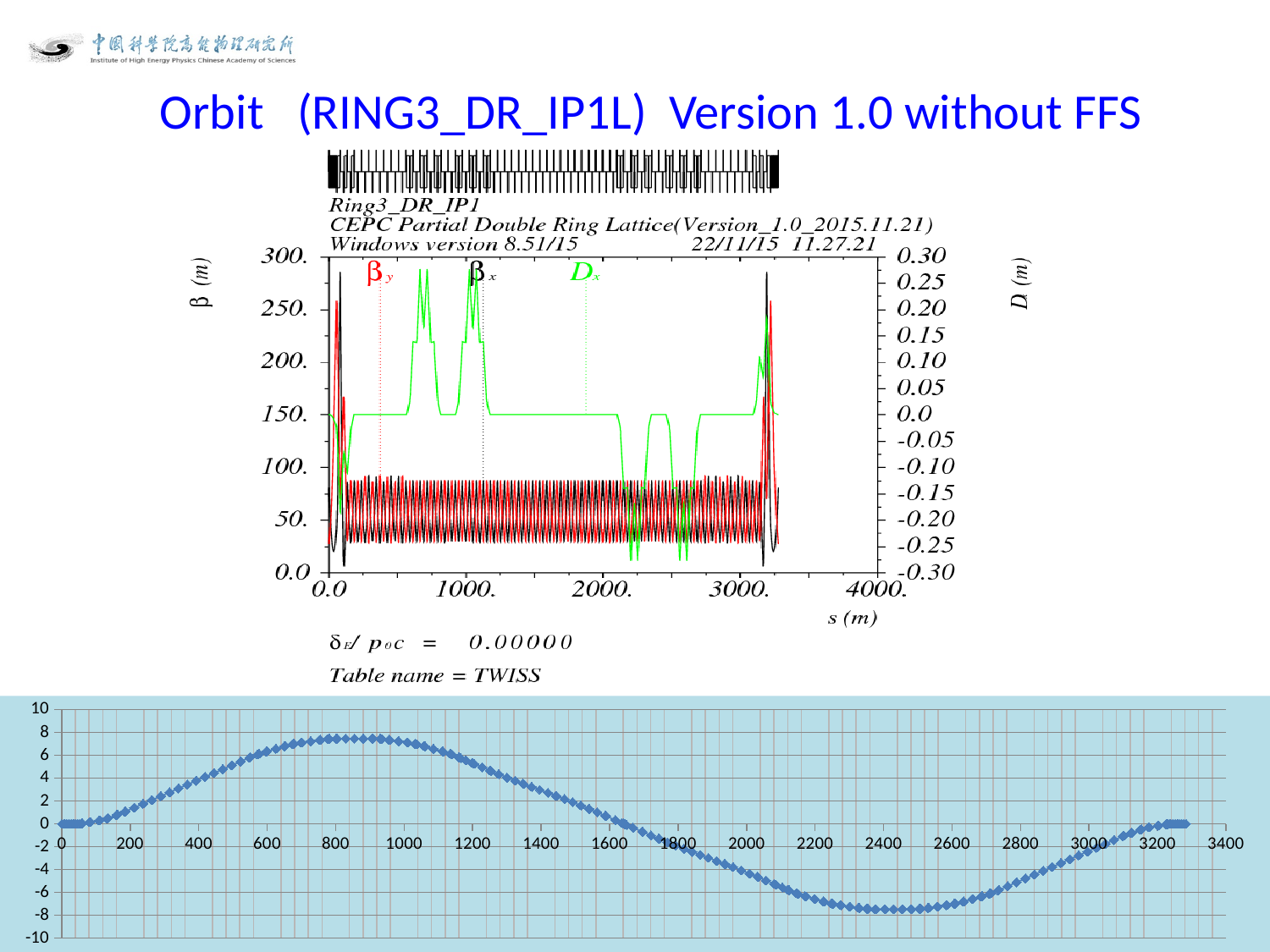
In the top (Twiss) chart, is the peak value of Dx greater or less than 0.20? greater In the bottom chart, do the values rise or fall as x goes from 1000 to 2400? fall In the bottom chart, is the value at x = 2400 greater or less than -6? less In the bottom chart, is the value at x = 1400 greater or less than 2? greater What kind of chart is the bottom chart on the slide? scatter chart In the bottom chart, do the values rise or fall as x goes from 0 to 800? rise In the bottom chart, which is larger: the value at x = 800 or the value at x = 1600? the value at x = 800 How many series does the legend of the top (Twiss) chart list? 3 In the top (Twiss) chart, what colour is the Dx curve? green